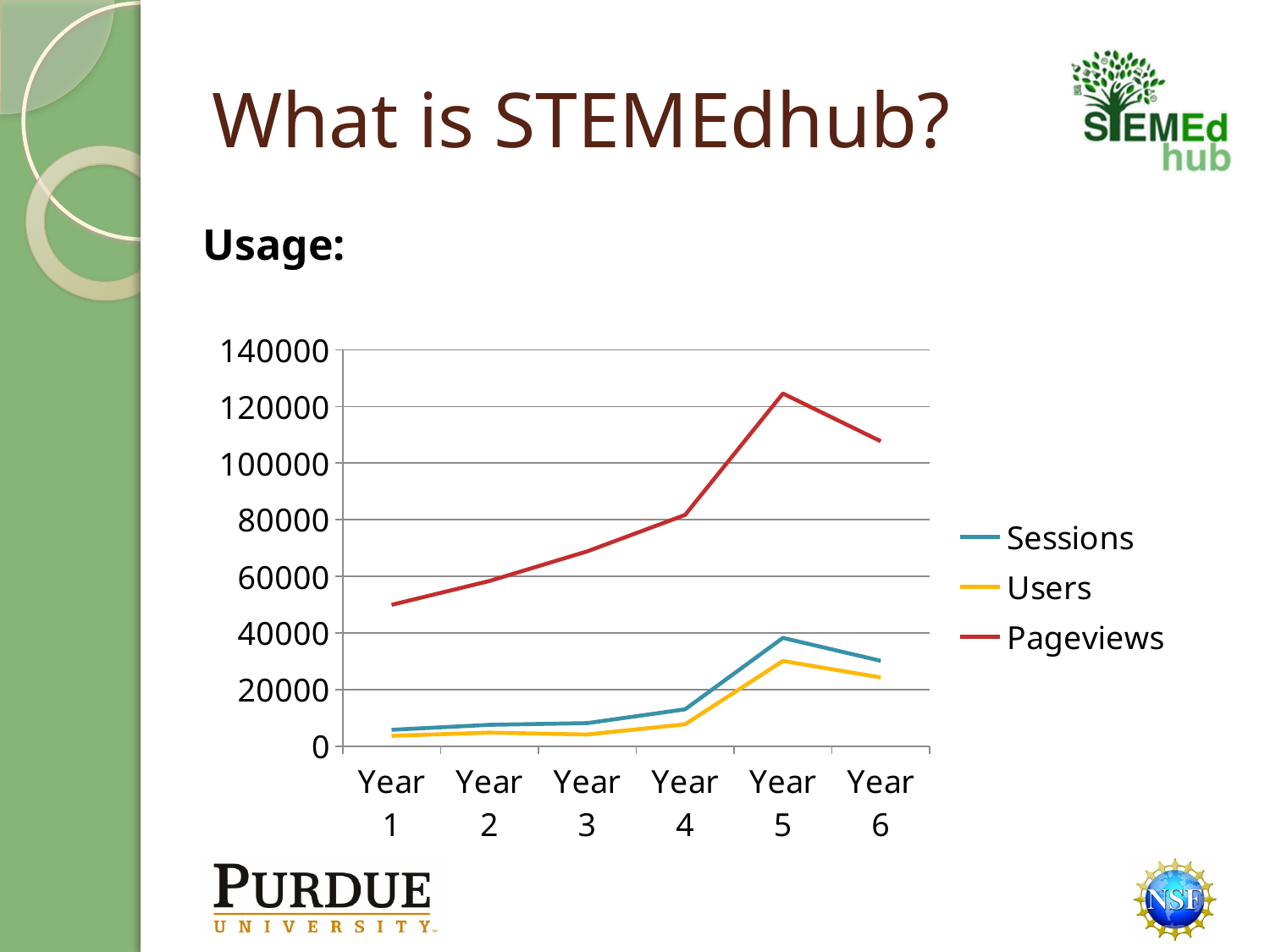
What kind of chart is shown on the slide? line chart Is the value for Sessions in Year 5 greater or less than 20000? greater In which year are Pageviews lowest? Year 1 Is the value for Pageviews in Year 1 greater or less than 60000? less Do Pageviews rise or fall from Year 1 to Year 5? rise In Year 5, which is larger: Sessions or Users? Sessions Is the value for Pageviews in Year 5 greater or less than 100000? greater How many years are plotted along the x axis? 6 How many series does the legend list? 3 In which year do Pageviews reach their highest value? Year 5 What colour is the Pageviews line? red In which year do Sessions reach their highest value? Year 5